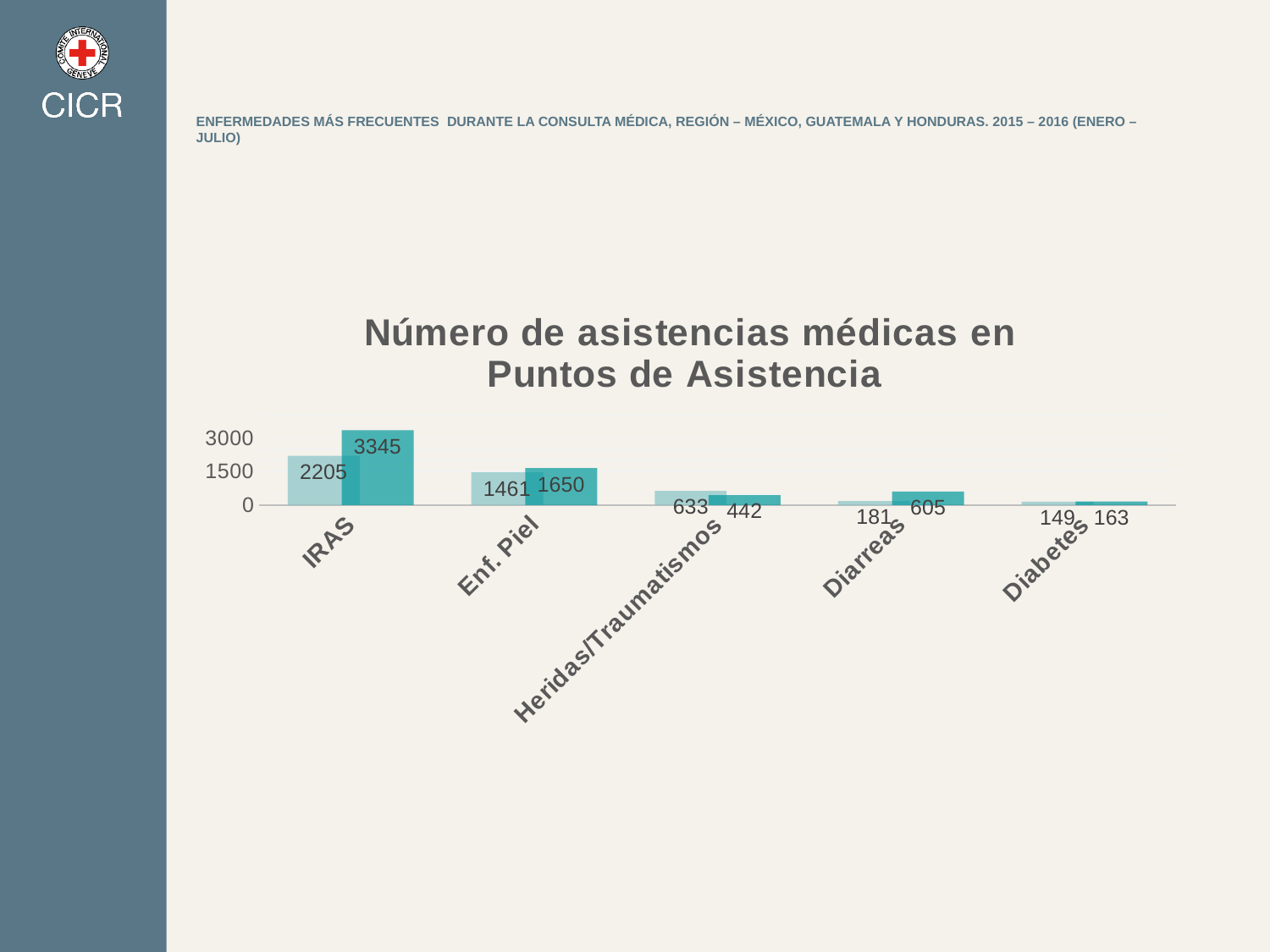
What is the value of the darker (second) bar for Diarreas? 605 What kind of chart is shown on the slide? bar chart Which category has the lowest value among the lighter (first) bars? Diabetes Which category has the highest value among the darker (second) bars? IRAS How many categories are shown on the x axis? 5 For Heridas/Traumatismos, which bar is larger, the lighter (first) or the darker (second)? the lighter (first) bar What is the value of the lighter (first) bar for Diabetes? 149 What is the value of the darker (second) bar for IRAS? 3345 What is the difference between the lighter and darker bars for Heridas/Traumatismos? 191 What is the difference between the darker and lighter bars for IRAS? 1140 What is the title of the chart? Número de asistencias médicas en Puntos de Asistencia What is the value of the lighter (first) bar for Enf. Piel? 1461